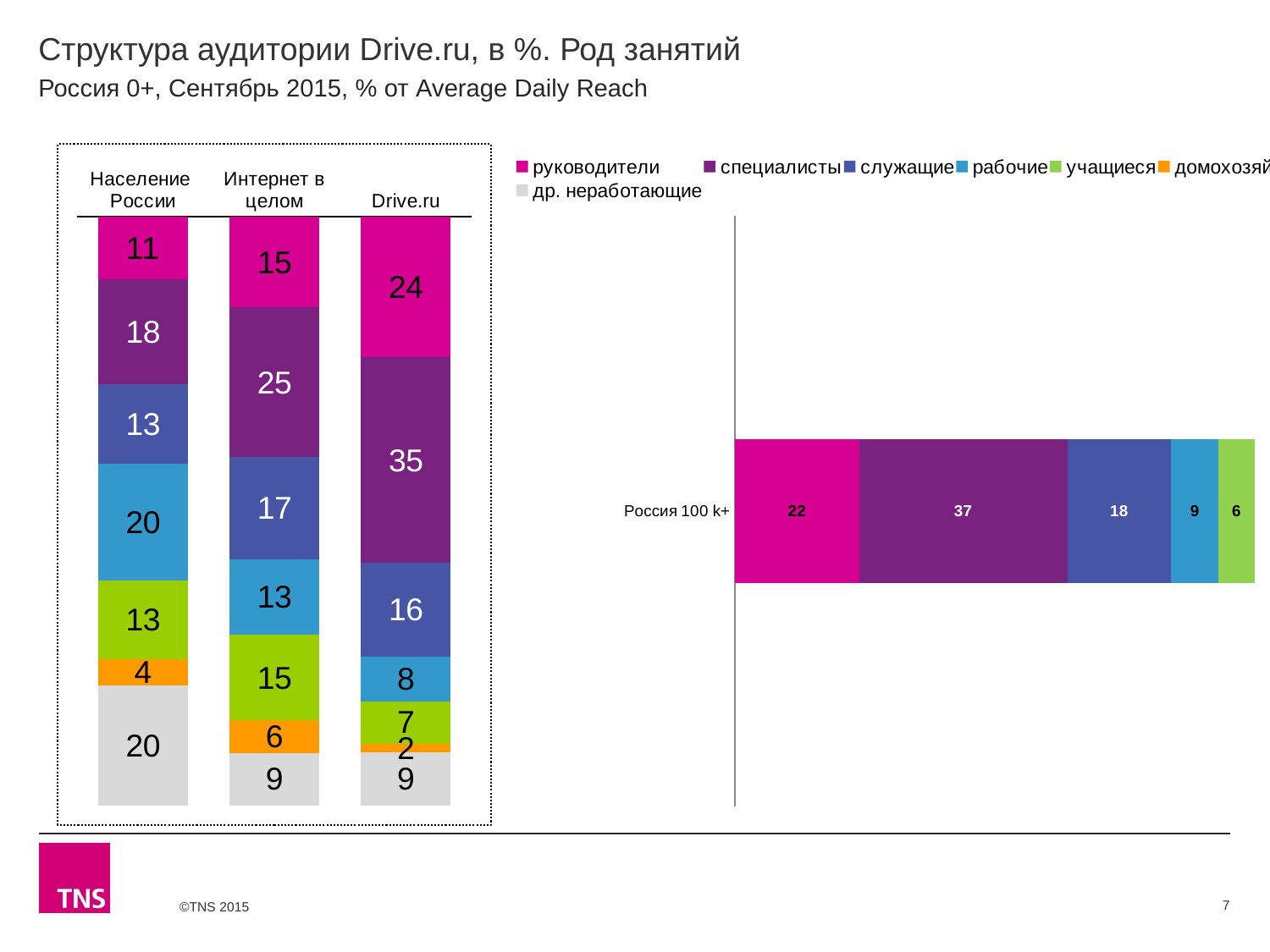
In the left chart, does the руководители value rise or fall going from Население России to Интернет в целом to Drive.ru? rise In the left stacked bar chart, which bar has the lowest value for домохозяйки? Drive.ru In the right chart (Россия 100 k+), what is the value for служащие? 18 In the left stacked bar chart, which has the larger специалисты value: Drive.ru or Интернет в целом? Drive.ru In the left stacked bar chart, what is the difference between the руководители value for Drive.ru and for Население России? 13 How many series does the legend list? 7 In the left stacked bar chart, what is the value for руководители in the Интернет в целом bar? 15 In the left stacked bar chart, what is the value for специалисты in the Drive.ru bar? 35 In the right chart (Россия 100 k+), which segment has the highest value? специалисты How many bars are shown in the left stacked bar chart? 3 In the left stacked bar chart, what is the value for рабочие in the Население России bar? 20 In the right chart (Россия 100 k+), what is the value for специалисты? 37